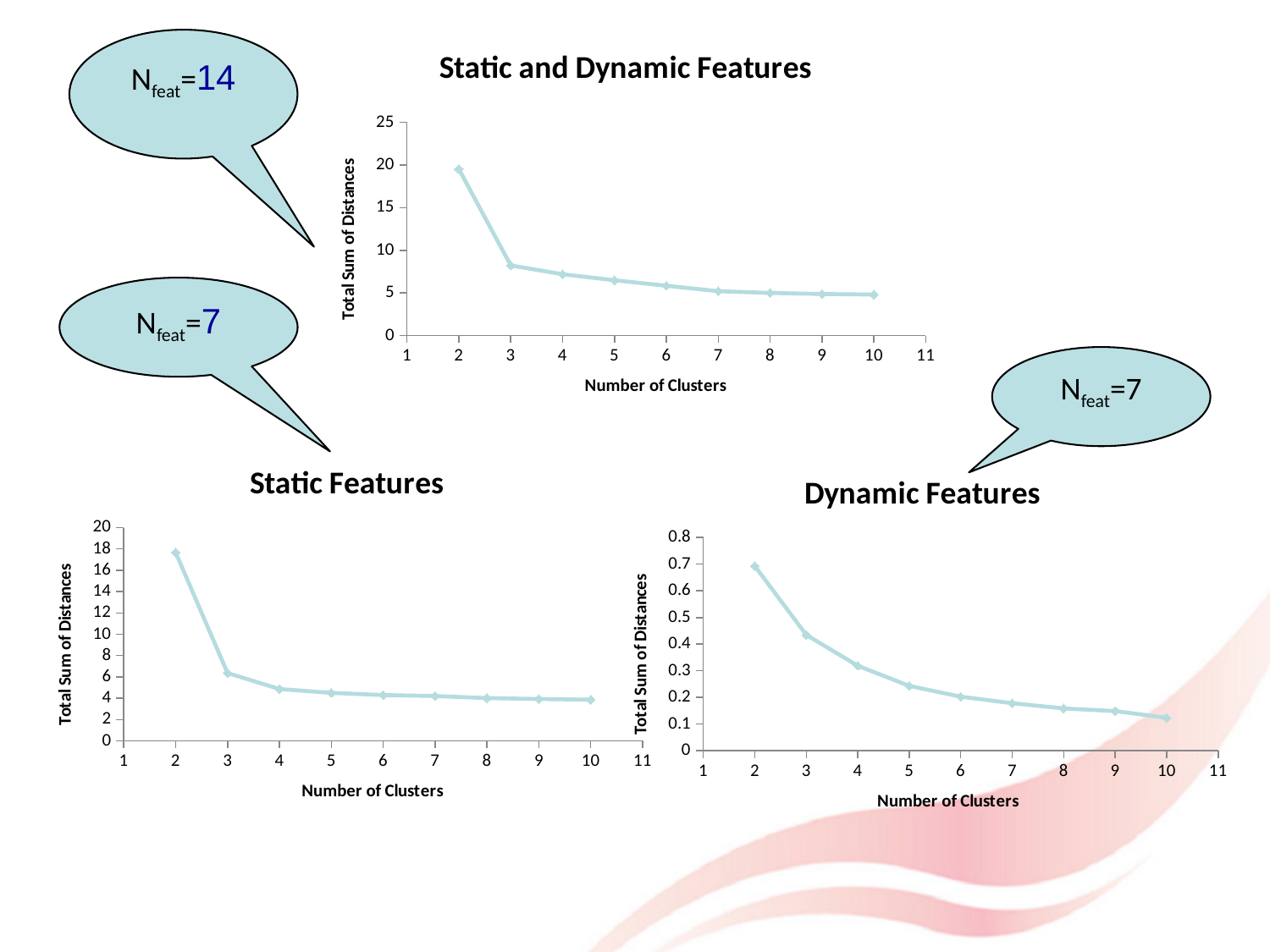
In the 'Static and Dynamic Features' chart, is the value at 10 clusters greater or less than 10? less In the 'Dynamic Features' chart, is the value at 2 clusters greater or less than 0.6? greater How many data points are plotted in the 'Static Features' chart? 9 In the 'Dynamic Features' chart, which number of clusters has the lowest total sum of distances? 10 In the 'Static and Dynamic Features' chart, do the values rise or fall as the number of clusters increases? fall In the 'Static and Dynamic Features' chart, is the value at 2 clusters greater or less than 15? greater In the 'Dynamic Features' chart, which is larger: the value at 3 clusters or the value at 6 clusters? 3 clusters What kind of chart is the 'Static and Dynamic Features' chart? line chart What is the label of the x axis in the 'Dynamic Features' chart? Number of Clusters What is the label of the y axis in the 'Static Features' chart? Total Sum of Distances In the 'Static Features' chart, which number of clusters has the highest total sum of distances? 2